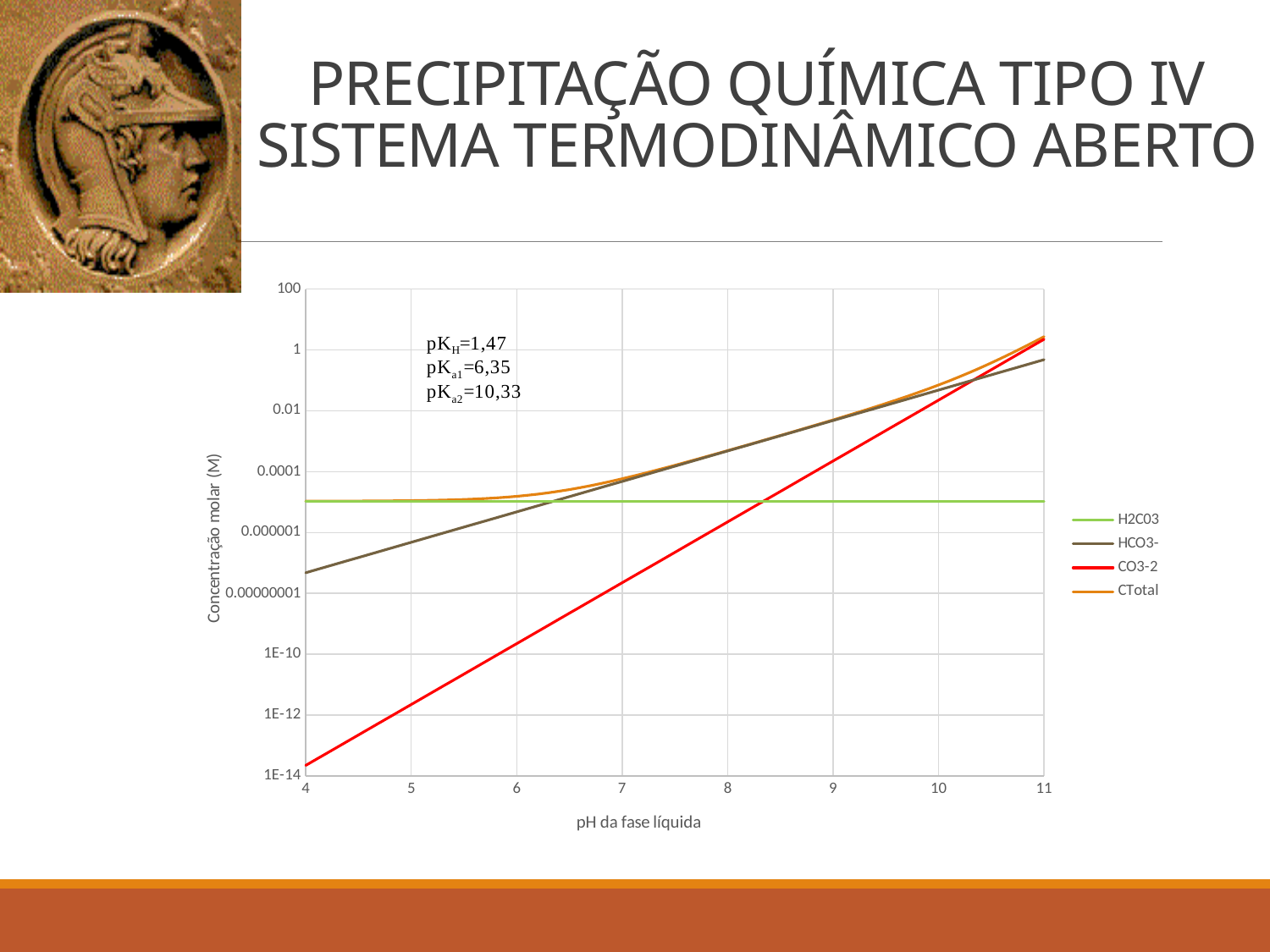
How many series does the chart legend list? 4 Is the value for H2C03 at pH 4 greater or less than 0.000001? greater Does the H2C03 series rise, fall or stay flat as pH increases from 4 to 11? stay flat Is the value for CO3-2 at pH 6 greater or less than 0.0001? less What are the series names listed in the chart legend? H2C03, HCO3-, CO3-2, CTotal Is the value for H2C03 at pH 4 greater or less than 0.0001? less At pH 4, which series has the higher value, H2C03 or CO3-2? H2C03 What is the title of the x axis of the chart? pH da fase líquida At pH 7, which series has the higher value, HCO3- or CO3-2? HCO3- Does the CO3-2 series rise or fall as pH increases from 4 to 11? rise What kind of chart is shown on the slide? line chart